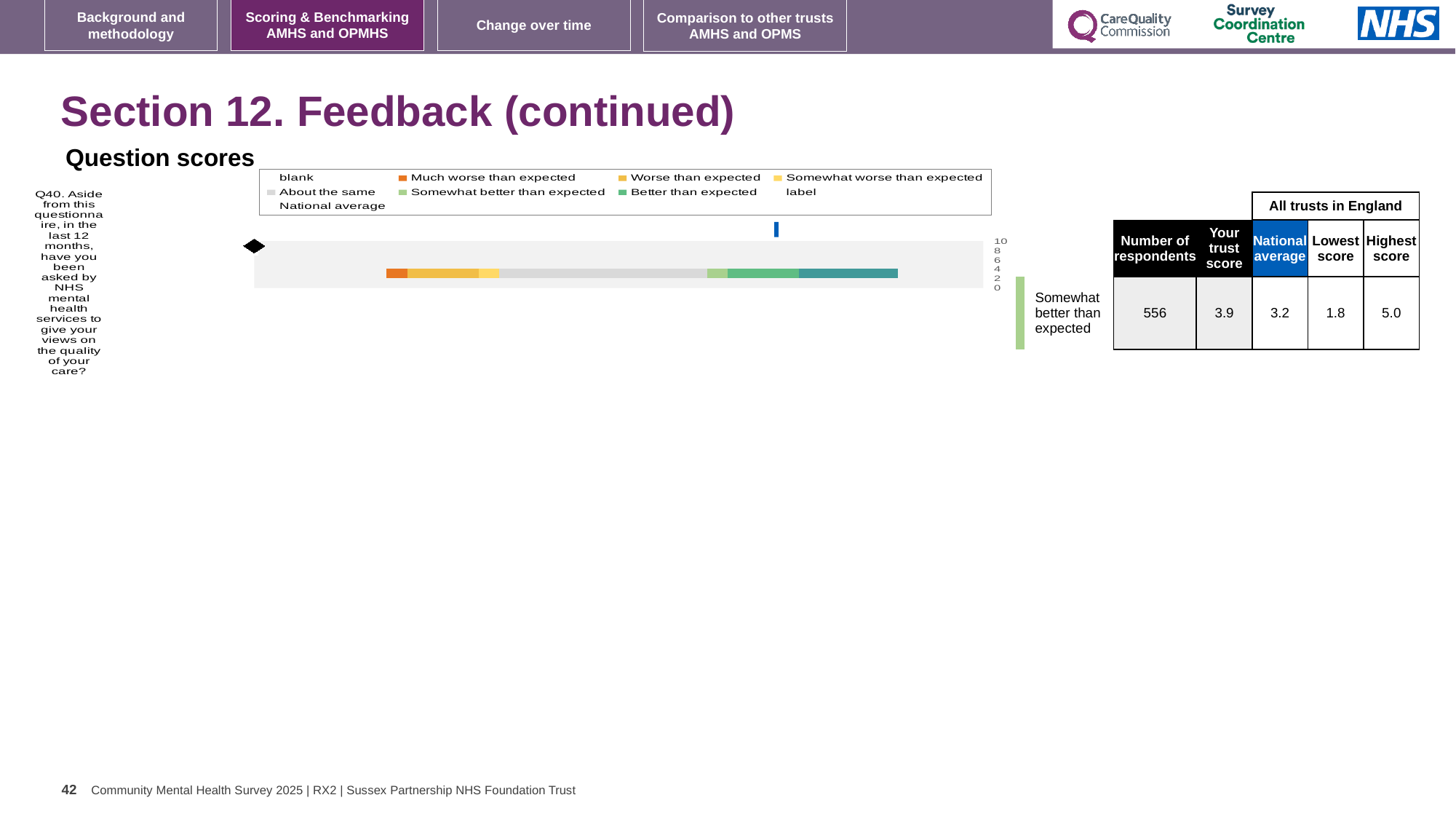
What is the trust score for Q40 shown next to the chart? 3.9 Is the trust score for Q40 higher or lower than the national average? higher What is the difference between the highest and lowest scores among all trusts in England for Q40? 3.2 What kind of chart is shown on the slide for Q40? bar chart What is the highest score among all trusts in England for Q40? 5.0 How many questions are plotted in the Question scores chart? 1 Which benchmark category is Q40 assigned to, according to the label beside the chart? Somewhat better than expected What is the difference between the trust score and the national average for Q40? 0.7 How many respondents answered Q40? 556 What is the national average for Q40 shown next to the chart? 3.2 What is the lowest score among all trusts in England for Q40? 1.8 Which legend entry in the chart is shown in orange? Much worse than expected